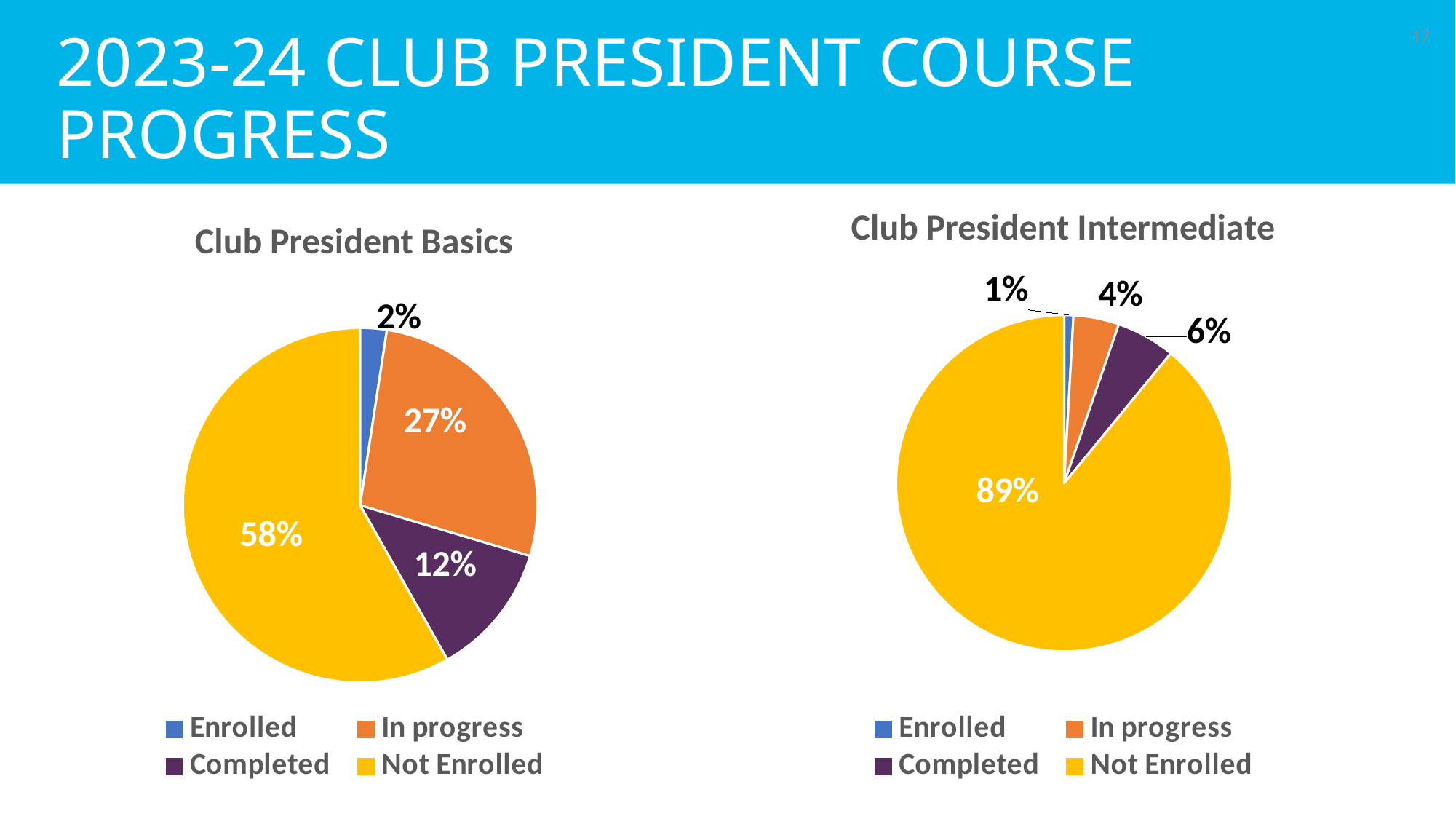
In the Club President Basics chart, what share of the pie is Not Enrolled? 58% In the Club President Intermediate chart, what share of the pie is Not Enrolled? 89% In the Club President Intermediate chart, which category has the largest slice? Not Enrolled In the Club President Intermediate chart, what percentage is In progress? 4% In the Club President Basics chart, which category has the smallest slice? Enrolled In the Club President Basics chart, what percentage is Enrolled? 2% In the Club President Basics chart, what percentage is Completed? 12% What type of chart is the Club President Basics chart? Pie chart In the Club President Basics chart, what percentage is In progress? 27% In the Club President Intermediate chart, what percentage is Completed? 6% In the Club President Basics chart, what is the difference between the In progress and Completed percentages? 15% In the Club President Intermediate chart, which is larger, Completed or In progress? Completed